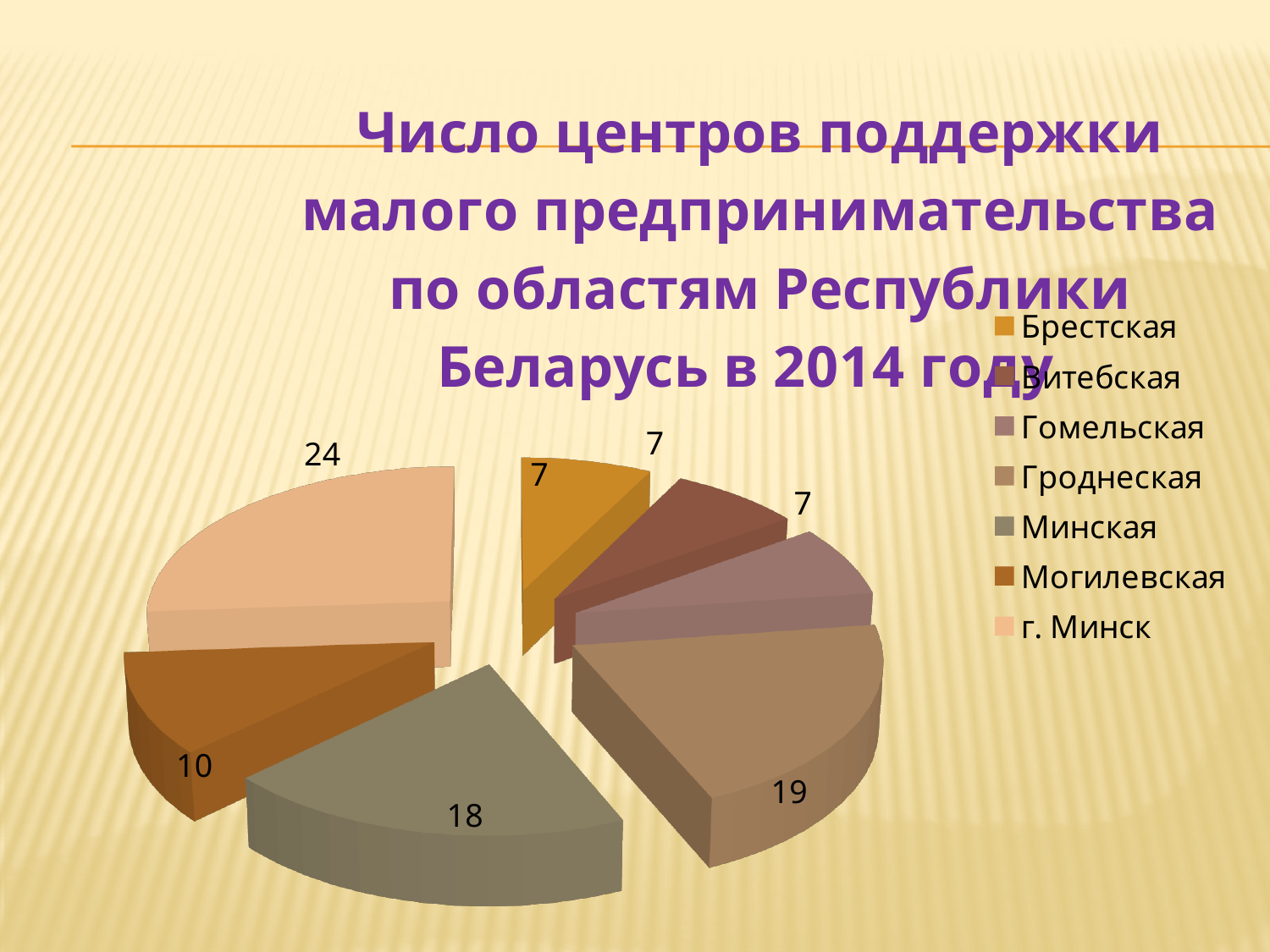
What is the total of all the values shown in the pie chart? 92 Which is larger, the value for Гроднеская or the value for Минская? Гроднеская Which region has the highest number of support centres? г. Минск What type of chart is shown on the slide? Pie chart What is the value for Могилевская? 10 What is the value for г. Минск? 24 What is the value for Гроднеская? 19 How many regions (slices) does the pie chart show? 7 What is the value for Брестская? 7 What is the difference between the values for г. Минск and Могилевская? 14 What is the title of the chart? Число центров поддержки малого предпринимательства по областям Республики Беларусь в 2014 году What is the value for Минская? 18